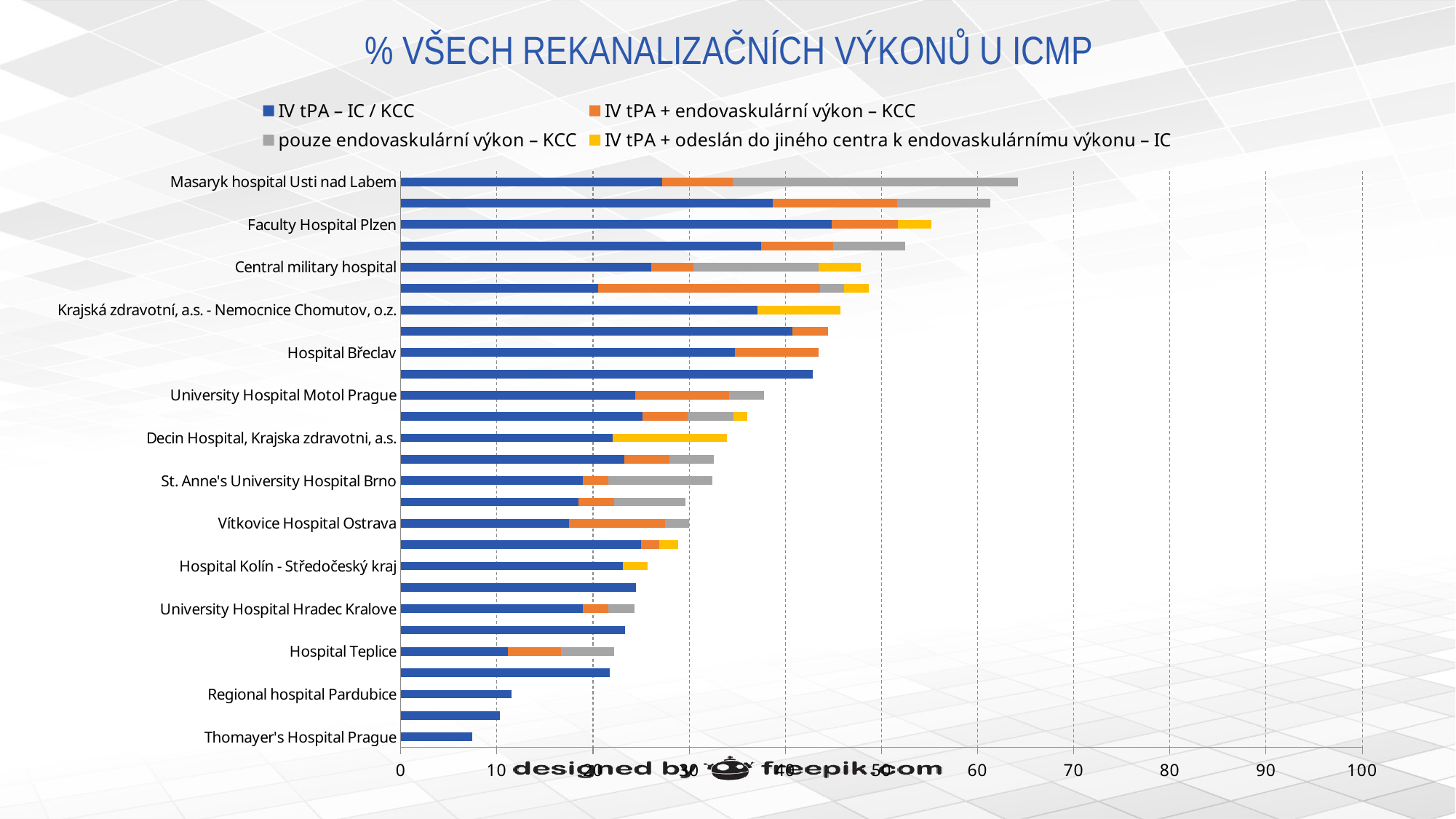
Is the total bar for Faculty Hospital Plzen greater or less than 50? greater Is the total bar for Hospital Kolín - Středočeský kraj greater or less than 30? less Is the total bar for University Hospital Motol Prague greater or less than 40? less What is the title of the chart? % VŠECH REKANALIZAČNÍCH VÝKONŮ U ICMP Which has the longer total bar, Faculty Hospital Plzen or Hospital Teplice? Faculty Hospital Plzen Which series is shown in blue in the legend? IV tPA – IC / KCC Which labelled hospital has the shortest total bar? Thomayer's Hospital Prague How many series does the legend list? 4 Which labelled hospital has the longest total bar? Masaryk hospital Usti nad Labem What kind of chart is shown on the slide? Stacked horizontal bar chart